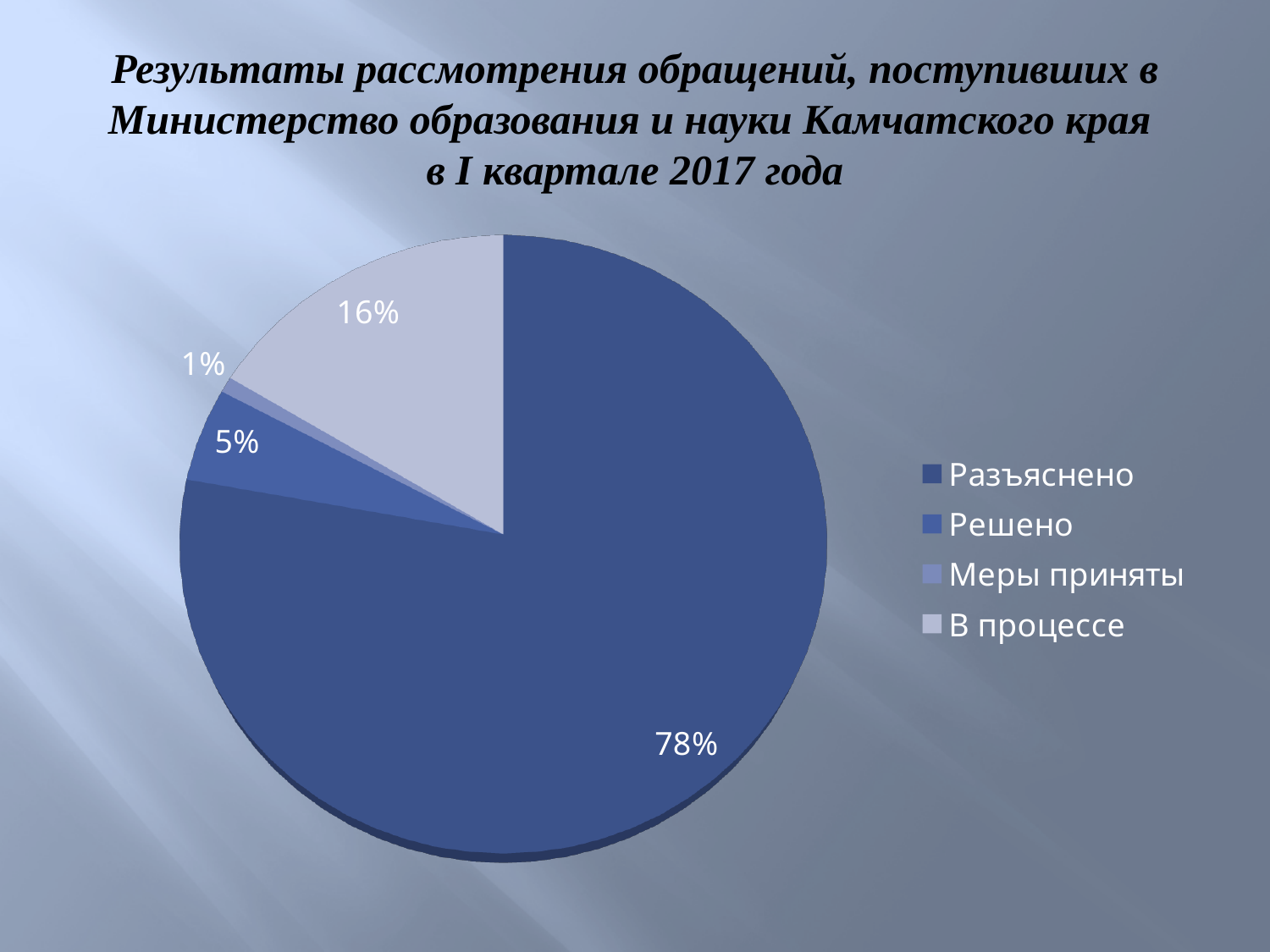
Which category has the smallest slice of the pie? Меры приняты Which legend entry is shown in the lightest colour? В процессе How many entries does the legend list? 4 What share of the pie does the "Разъяснено" slice represent? 78% What share of the pie does the "Решено" slice represent? 5% How many categories does the pie chart show? 4 What share of the pie does the "В процессе" slice represent? 16% Which category has the largest slice of the pie? Разъяснено What kind of chart is shown on the slide? Pie chart Which slice is larger, "Решено" or "В процессе"? В процессе What is the difference in percentage points between the "Разъяснено" and "В процессе" slices? 62